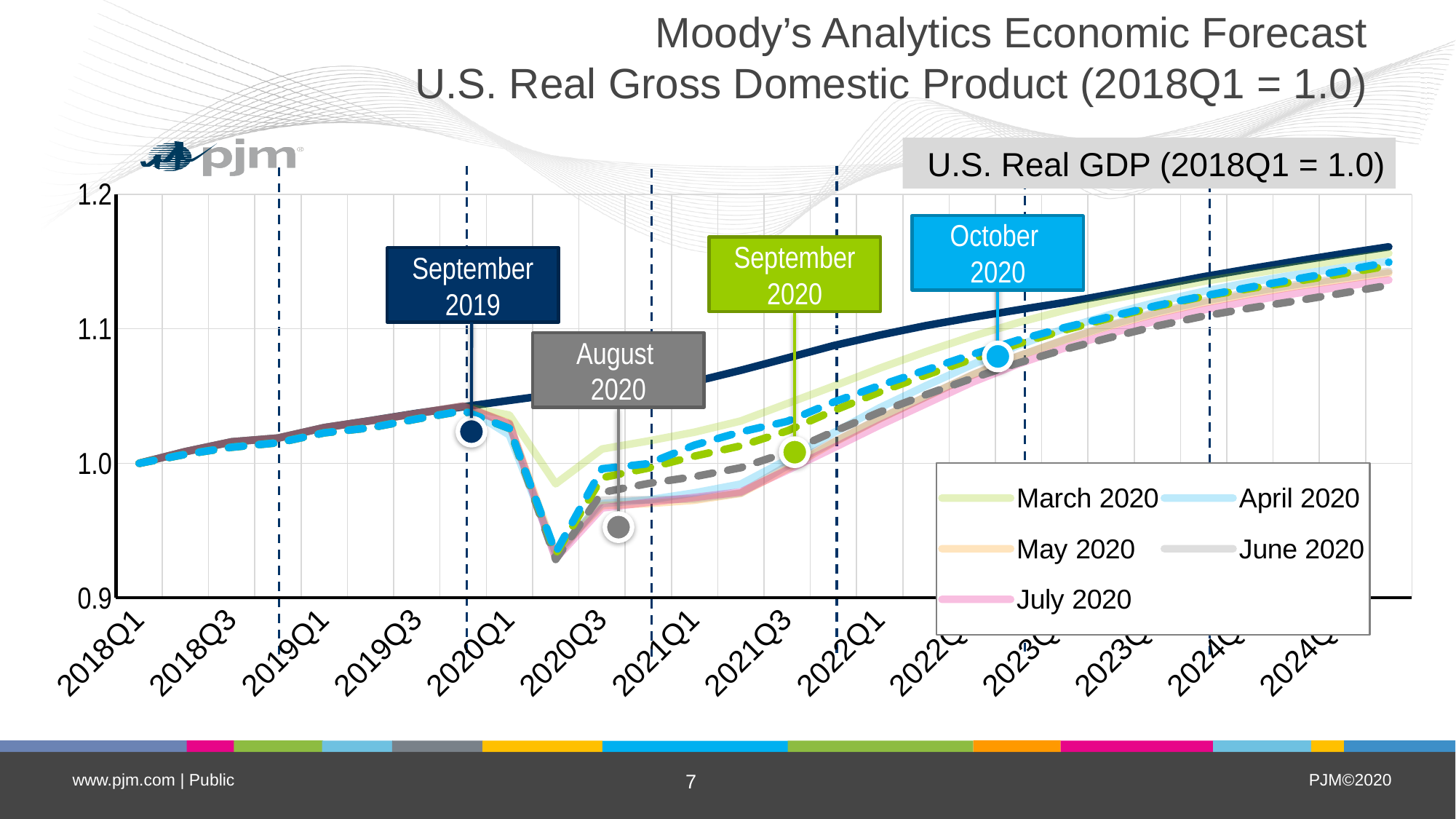
Is the lowest value of the August 2020 forecast greater or less than 1.0? less Which forecast line is the highest at 2024Q3? September 2019 How many series does the legend list? 5 What is the highest value shown on the y axis? 1.2 At 2024Q3, is the September 2019 forecast or the June 2020 forecast higher? September 2019 What kind of chart is shown on the slide? line chart Is the value of the September 2019 forecast at 2020Q1 greater or less than 1.0? greater What is the value of U.S. Real GDP at 2018Q1 in the chart? 1.0 Does the September 2019 forecast line rise or fall from 2018Q1 to 2024Q3? rises Is the value of the September 2019 forecast at 2024Q3 greater or less than 1.1? greater What is the title shown in the box above the chart? U.S. Real GDP (2018Q1 = 1.0) Which forecast line is the lowest at 2024Q3? August 2020